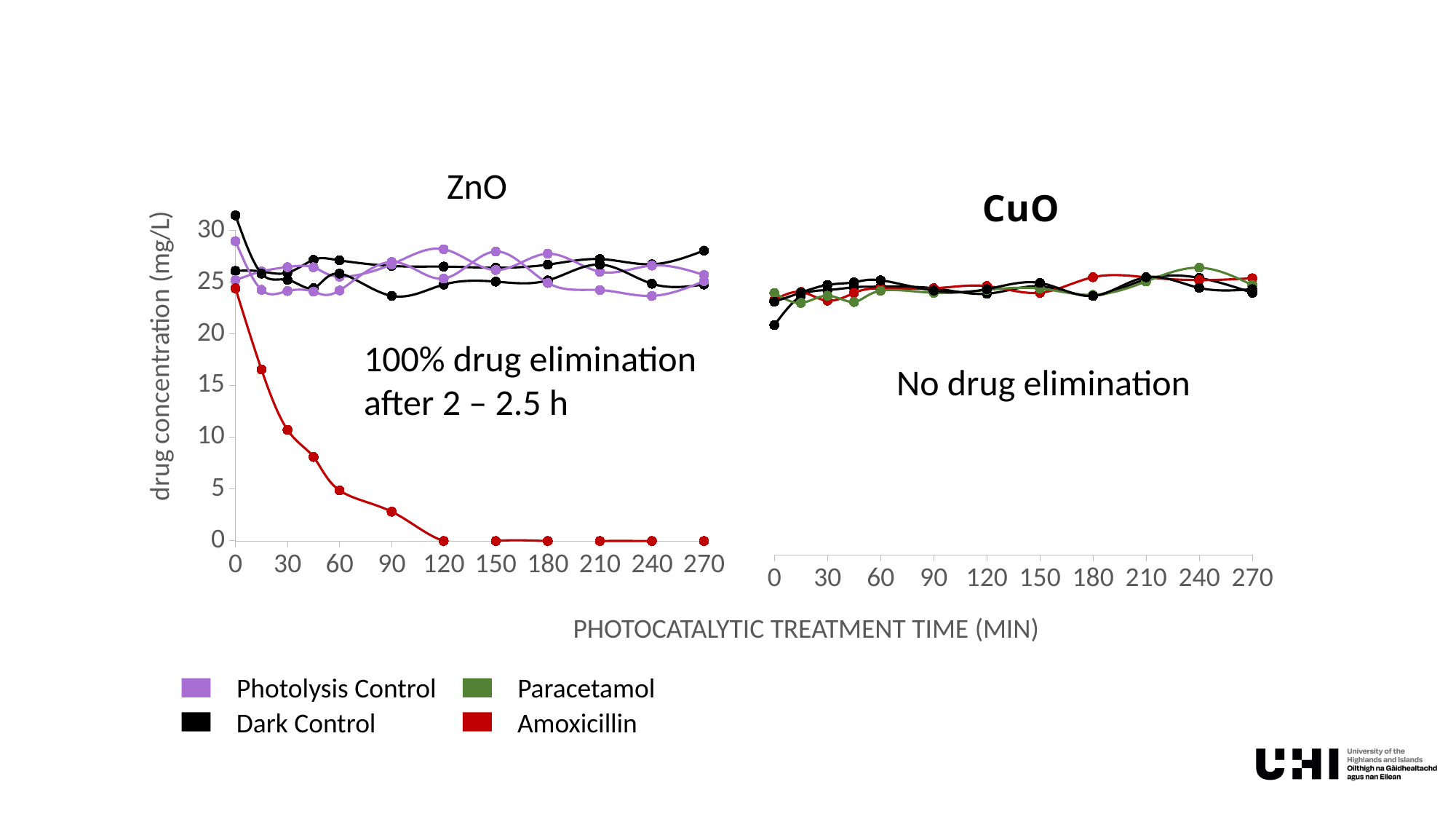
How many series does the legend list? 4 In the ZnO chart, is the Amoxicillin value at 60 min greater or less than 10? less In the ZnO chart, what is the Amoxicillin concentration at 120 min? 0 What kind of chart is the ZnO chart? line chart What is the x-axis label shared by the two charts? PHOTOCATALYTIC TREATMENT TIME (MIN) In the ZnO chart, which is larger at 270 min: Dark Control or Amoxicillin? Dark Control In the ZnO chart, which series has the highest value at 0 min? Dark Control In the ZnO chart, is the Amoxicillin value at 0 min greater or less than 20? greater In the ZnO chart, does the Amoxicillin concentration rise or fall as treatment time increases? fall In the ZnO chart, which series has the lowest value at 270 min? Amoxicillin In the CuO chart, is the Dark Control value at 0 min greater or less than 25? less